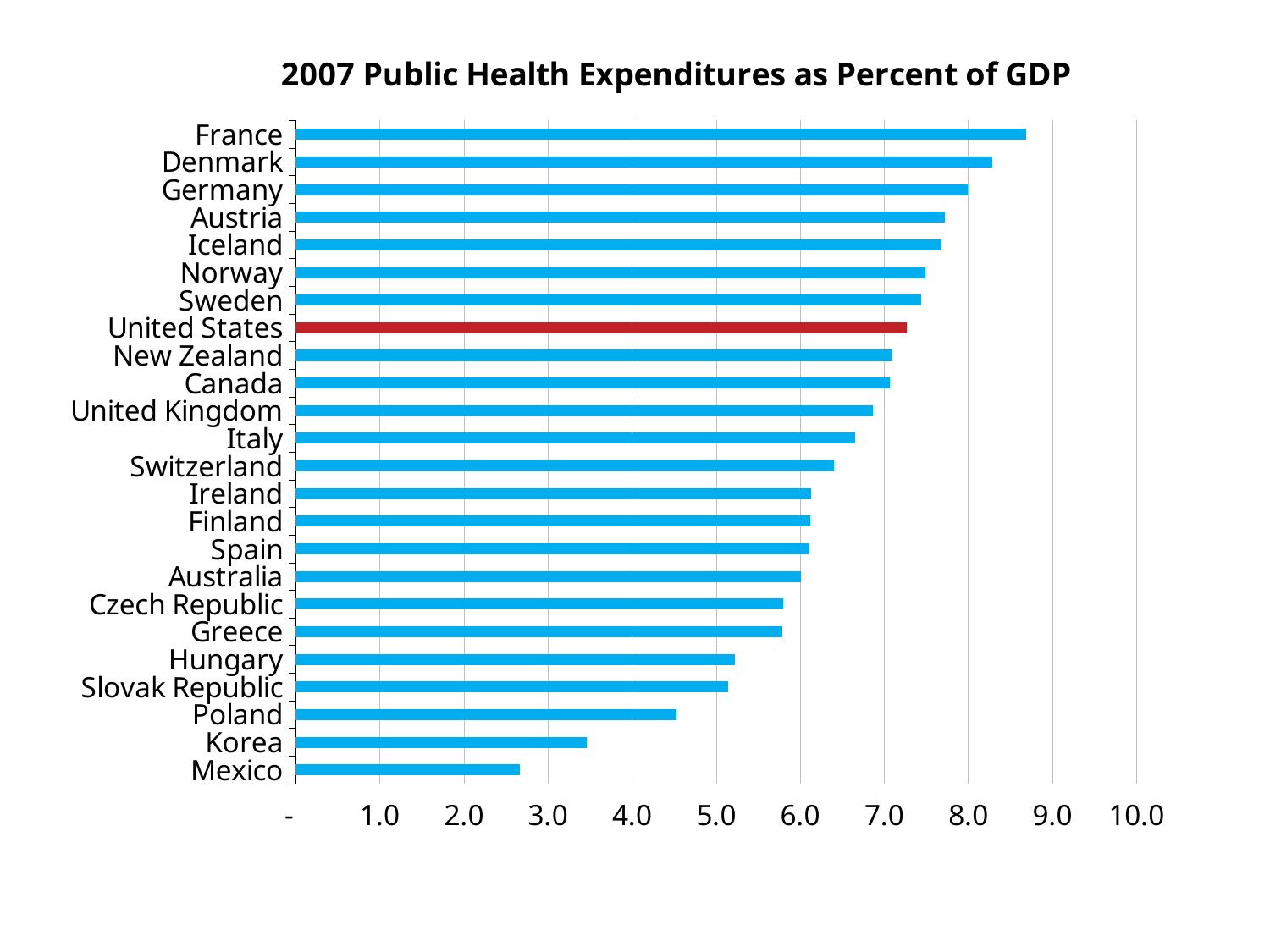
What is the title of the chart? 2007 Public Health Expenditures as Percent of GDP Which country has the lowest public health expenditure as percent of GDP? Mexico Is the value for Mexico greater or less than 3.0? less Which has a larger value, Korea or Poland? Poland Which has a larger value, the United States or the United Kingdom? United States Is the value for the United States greater or less than 7.0? greater Which country's bar is highlighted in red? United States Which country has the highest public health expenditure as percent of GDP? France What kind of chart is shown on the slide? bar chart Is the value for France greater or less than 8.0? greater How many countries are shown in the chart? 24